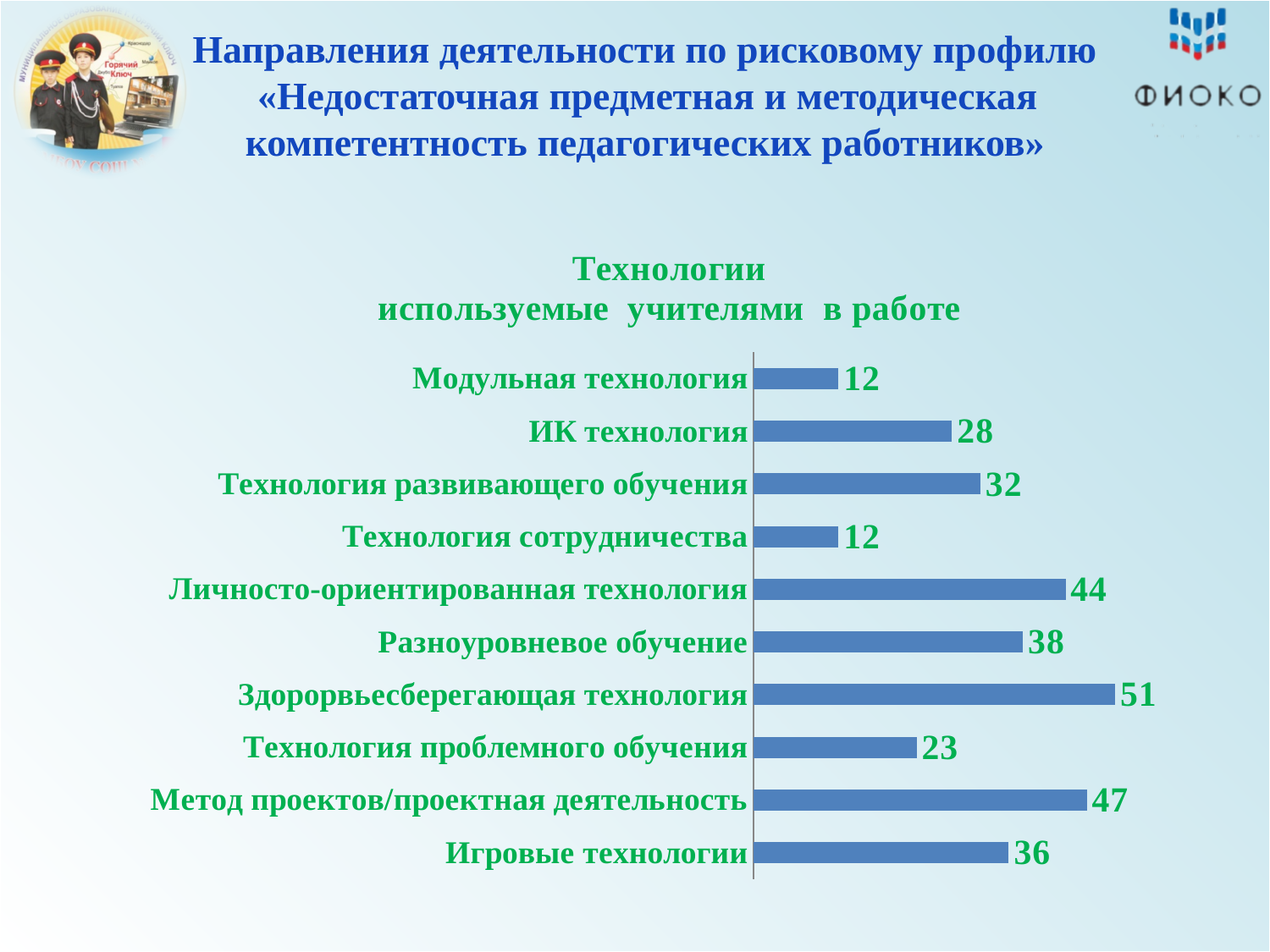
What kind of chart is shown on the slide? Bar chart How many categories are shown in the chart? 10 What is the difference between the values for «Метод проектов/проектная деятельность» and «ИК технология»? 19 What value is shown for «Игровые технологии»? 36 Which is larger, the value for «Разноуровневое обучение» or the value for «Метод проектов/проектная деятельность»? Метод проектов/проектная деятельность What is the difference between the values for «Здорорвьесберегающая технология» and «Разноуровневое обучение»? 13 Which is larger, the value for «Технология развивающего обучения» or the value for «Игровые технологии»? Игровые технологии What value is shown for «Модульная технология»? 12 What is the title of the chart? Технологии используемые учителями в работе What value is shown for «Технология проблемного обучения»? 23 Which category has the highest value? Здорорвьесберегающая технология What value is shown for «Личносто-ориентированная технология»? 44